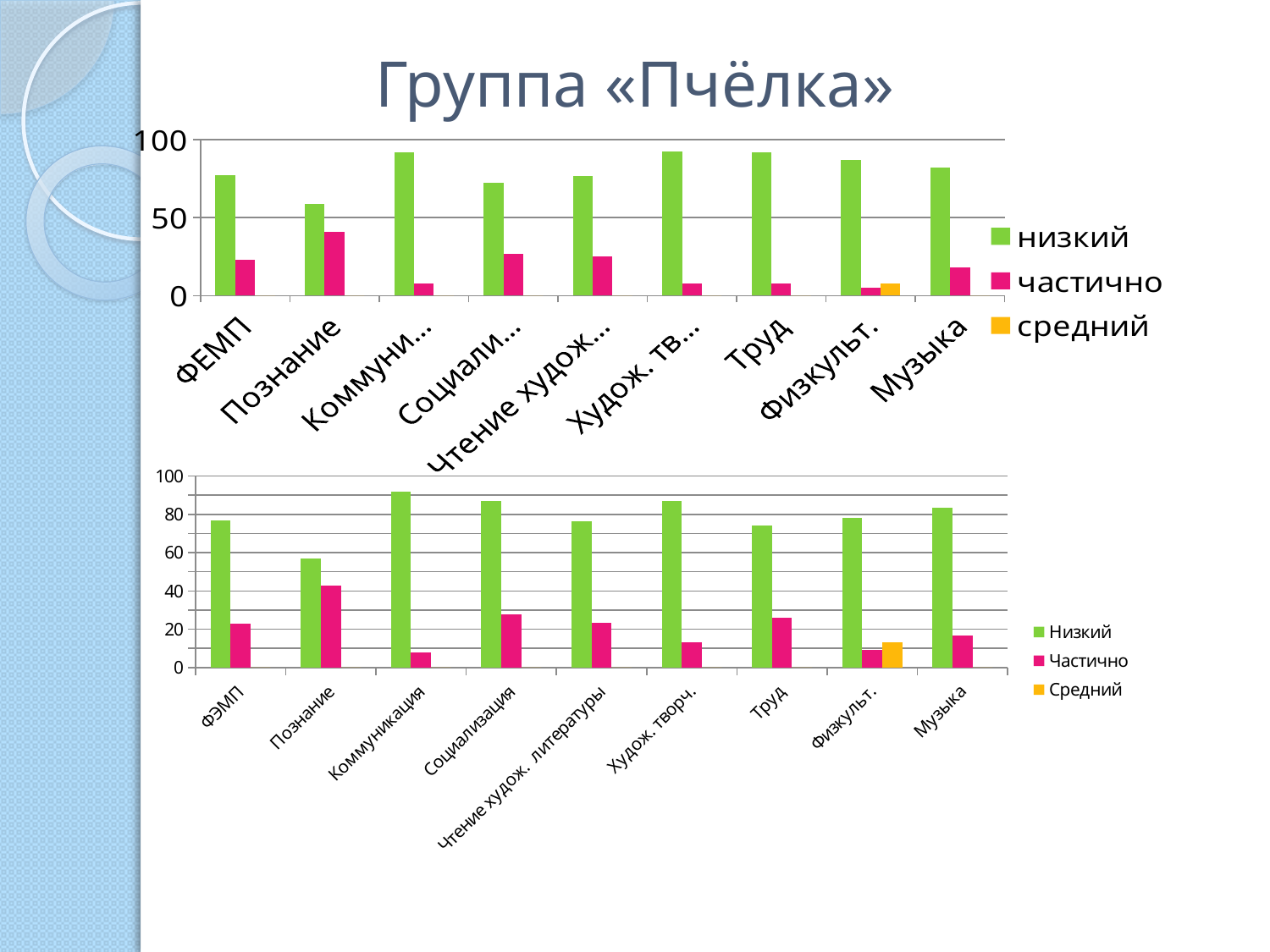
In the top chart, which is larger for Труд: the низкий value or the частично value? низкий In the bottom chart, which category has the highest value for the Частично series? Познание In the bottom chart, which category has the highest value for the Низкий series? Коммуникация In the top chart, which category has the lowest value for the низкий series? Познание In the bottom chart, is the Низкий value for Познание greater or less than 80? less In the bottom chart, is the Частично value for Познание greater or less than 20? greater In the bottom chart, which category is the only one with a visible bar for the Средний series? Физкульт. In the bottom chart, which category has the lowest value for the Низкий series? Познание What kind of chart is the top chart on the slide? bar chart In the bottom chart, is the Средний value for Физкульт. greater or less than 20? less How many series does the legend of the top chart list? 3 How many categories are shown on the x axis of the bottom chart? 9